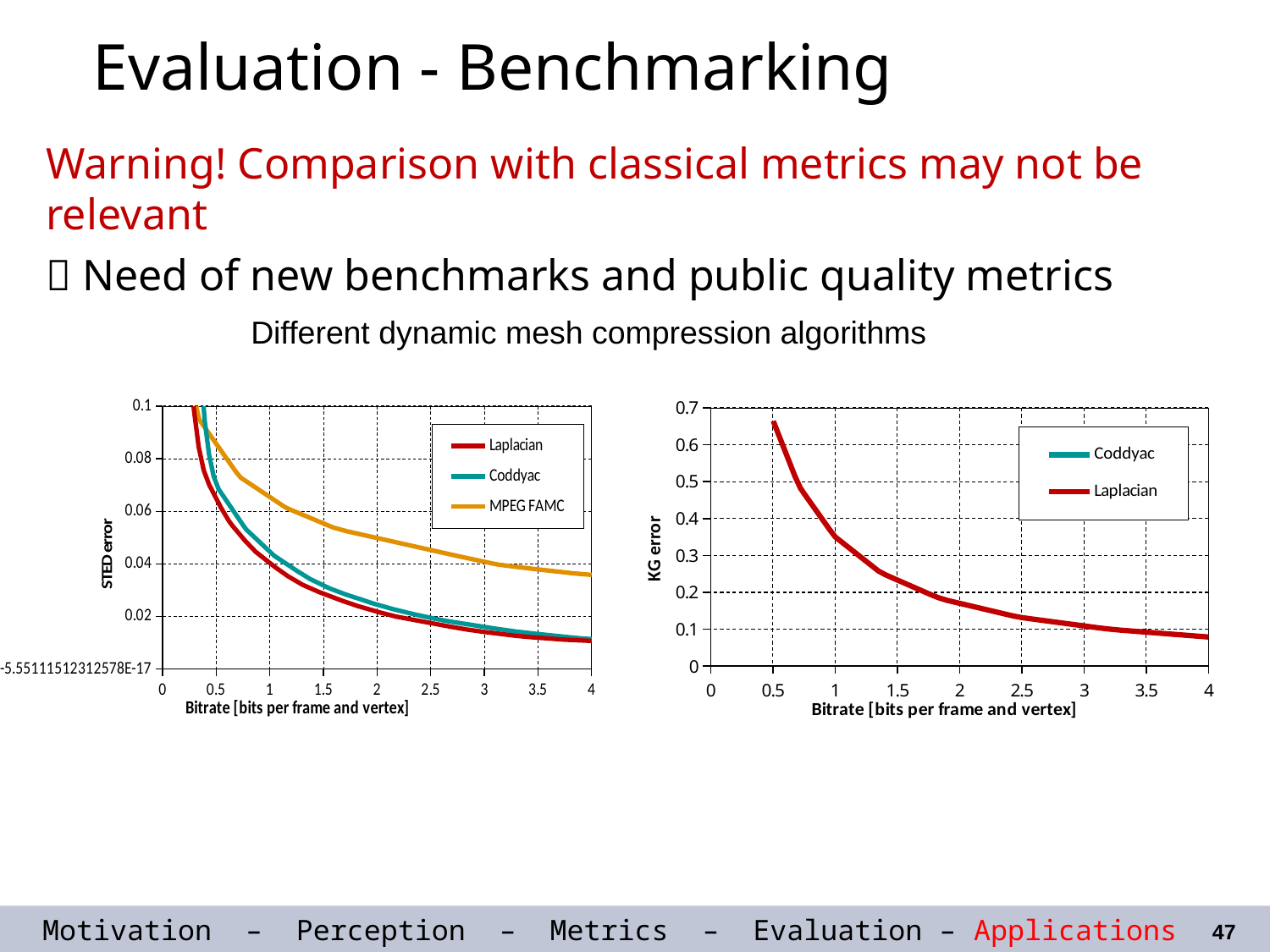
In the left chart (STED error), is the MPEG FAMC value at a bitrate of 2 greater or less than 0.04? greater In the left chart (STED error), which series has the highest STED error across the bitrate range? MPEG FAMC What type of chart is the left chart (STED error)? line chart In the right chart (KG error), is the Laplacian value at a bitrate of 0.5 greater or less than 0.6? greater In the right chart (KG error), is the Laplacian value at a bitrate of 2 greater or less than 0.2? less In the left chart (STED error), at a bitrate of 1, which series has the larger STED error, MPEG FAMC or Laplacian? MPEG FAMC In the left chart (STED error), do the STED error values rise or fall as bitrate increases? fall In the right chart (KG error), does the KG error rise or fall as bitrate increases? fall What is the x-axis label of the right chart (KG error)? Bitrate [bits per frame and vertex] How many series does the legend of the left chart (STED error) list? 3 How many series does the legend of the right chart (KG error) list? 2